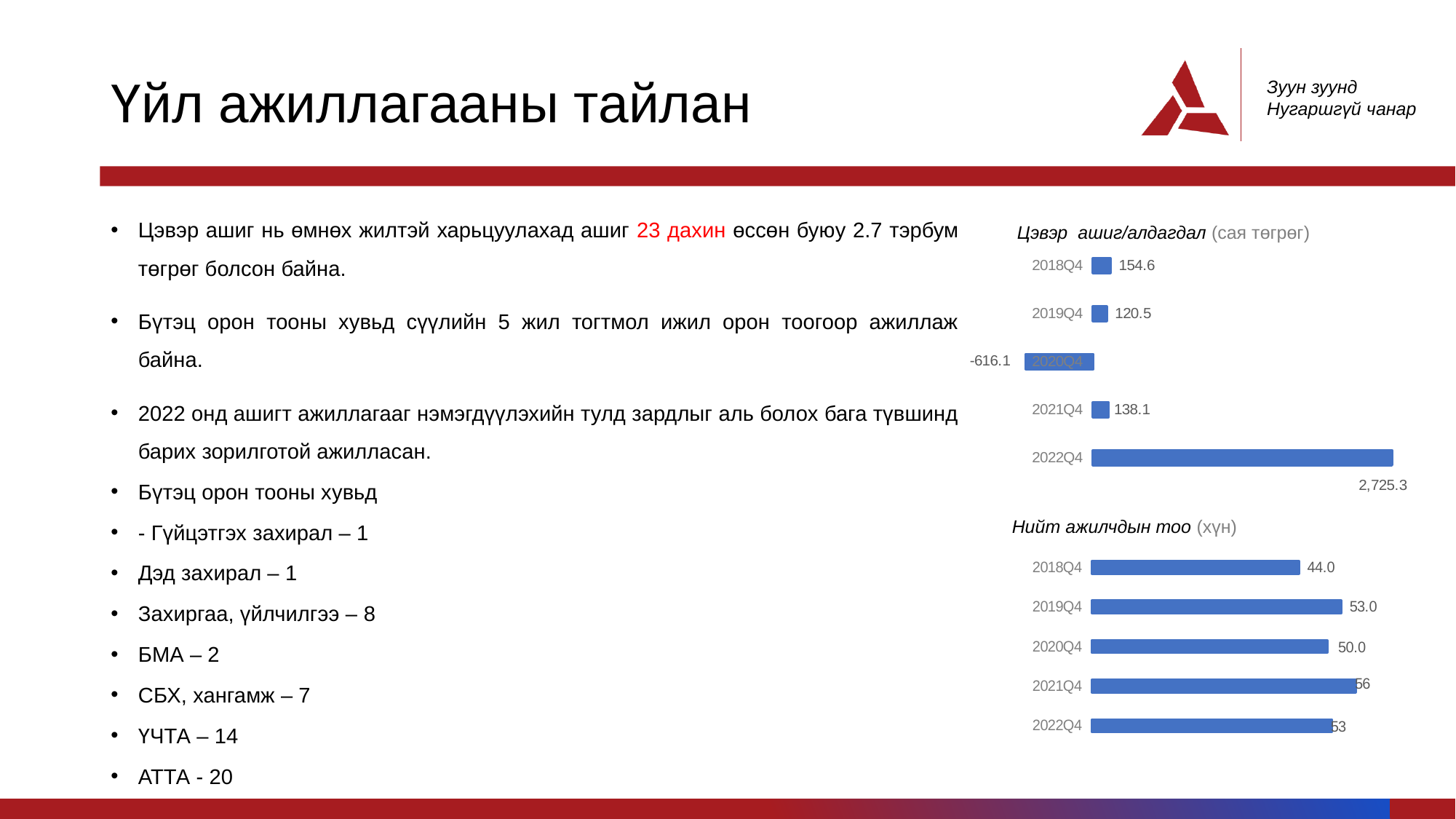
In the 'Цэвэр ашиг/алдагдал' chart, what is the difference between the 2018Q4 and 2019Q4 values? 34.1 In the 'Цэвэр ашиг/алдагдал' chart, which period has the highest value? 2022Q4 In the 'Цэвэр ашиг/алдагдал' chart, which period has the lowest value? 2020Q4 In the 'Нийт ажилчдын тоо' chart, what is the value for 2018Q4? 44.0 In the 'Цэвэр ашиг/алдагдал' chart, what is the value for 2020Q4? -616.1 In the 'Цэвэр ашиг/алдагдал' chart, what is the value for 2022Q4? 2,725.3 In the 'Нийт ажилчдын тоо' chart, which period has the lowest value? 2018Q4 In the 'Нийт ажилчдын тоо' chart, what is the value for 2021Q4? 56 In the 'Нийт ажилчдын тоо' chart, is the value for 2019Q4 or 2020Q4 larger? 2019Q4 What type of chart is the 'Нийт ажилчдын тоо' chart? Bar chart In the 'Цэвэр ашиг/алдагдал' chart, what is the value for 2019Q4? 120.5 In the 'Цэвэр ашиг/алдагдал' chart, how many periods are shown? 5